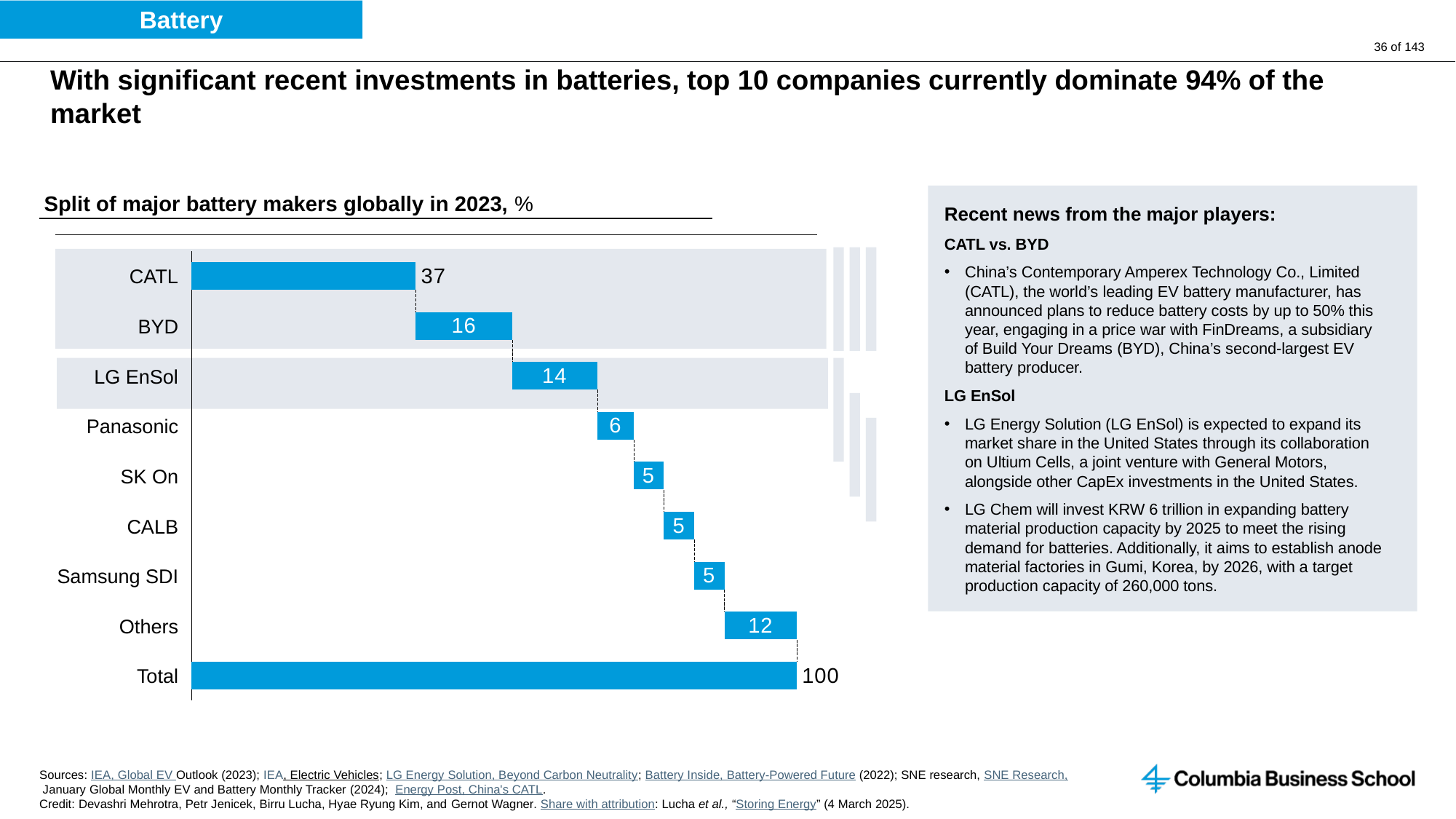
What is the difference between the values for LG EnSol and Panasonic? 8 What kind of chart is used to show the split of major battery makers? Bar chart (waterfall) What is the value shown for the Total bar? 100 Which is larger, the value for BYD or the value for Others? BYD What is the value for LG EnSol in the chart? 14 How many categories (including Others and Total) are shown on the chart's vertical axis? 9 What is the difference between the values for CATL and BYD? 21 Which named company has the highest share in the chart? CATL What is the value for CATL in the chart 'Split of major battery makers globally in 2023, %'? 37 What is the value for BYD in the chart? 16 What is the value for Others in the chart? 12 What unit is stated in the chart title 'Split of major battery makers globally in 2023'? %